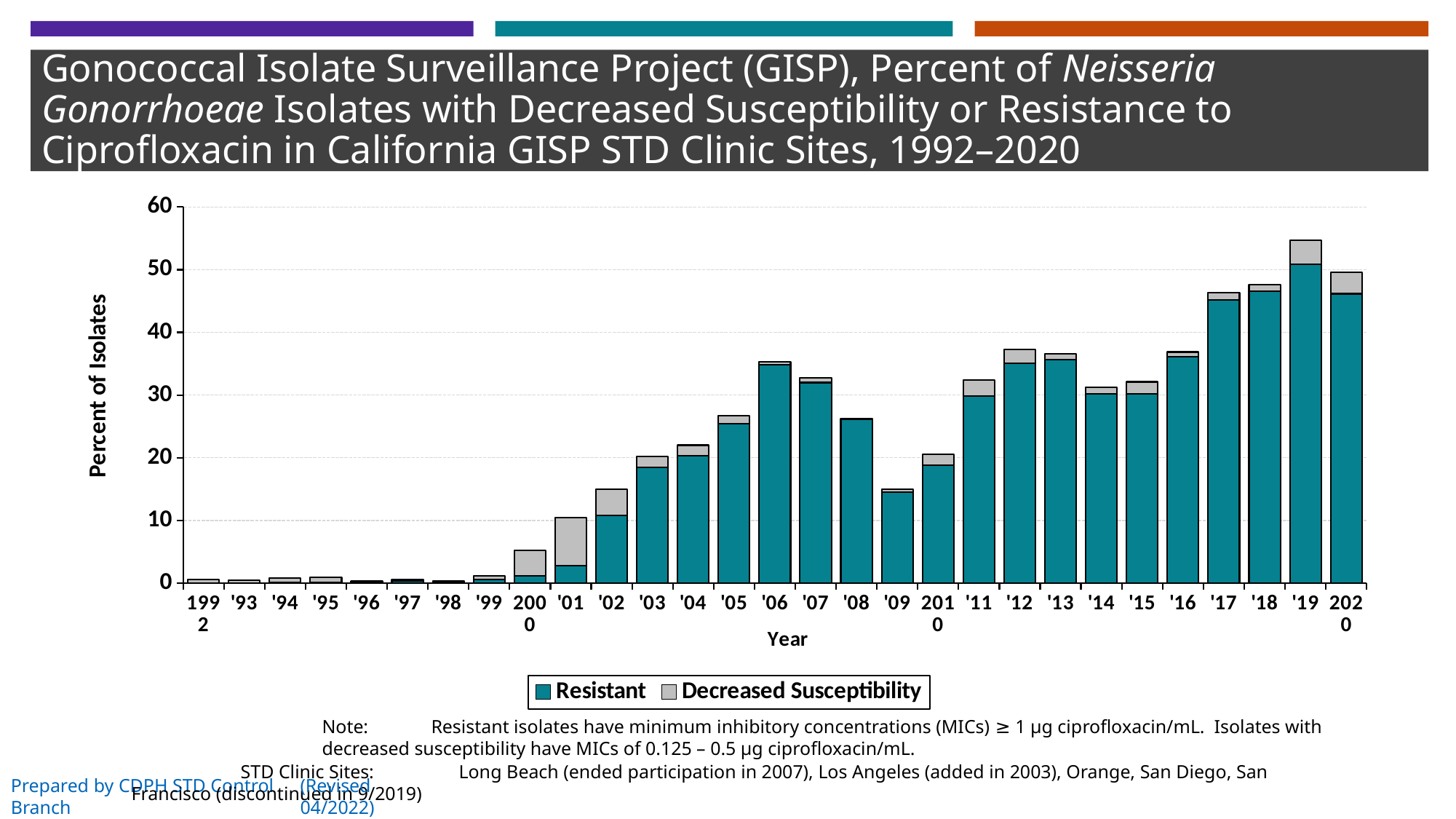
Is the total value for 2009 greater or less than 20? less What is the label on the y axis? Percent of Isolates Is the Resistant value for 2006 greater or less than 30? greater Which year has the larger total percent of isolates, 2019 or 2020? 2019 How many series does the legend list? 2 Is the total value for 2019 greater or less than 50? greater What kind of chart is shown on the slide? stacked bar chart Do the total values rise or fall from 2016 to 2019? rise Which year has the highest total percent of isolates? 2019 How many years (bars) are plotted on the x axis? 29 Which year has the larger total percent of isolates, 2006 or 2009? 2006